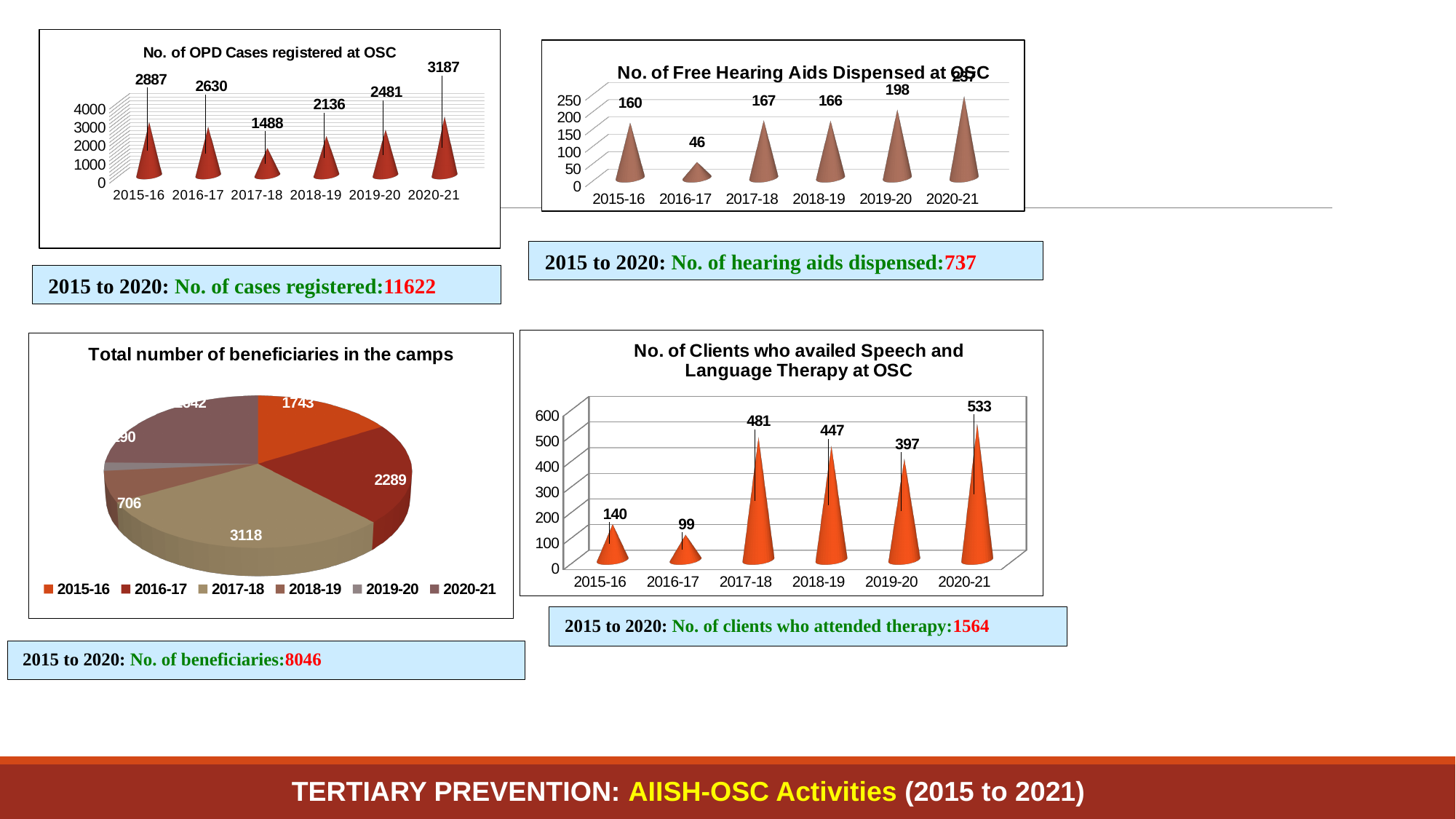
In the 'No. of Clients who availed Speech and Language Therapy at OSC' chart, do the values rise or fall from 2017-18 to 2019-20? Fall In the 'Total number of beneficiaries in the camps' chart, what is the value for 2017-18? 3118 In the 'No. of OPD Cases registered at OSC' chart, what is the difference between the values for 2015-16 and 2016-17? 257 In the 'No. of Free Hearing Aids Dispensed at OSC' chart, what is the value for 2016-17? 46 In the 'No. of Free Hearing Aids Dispensed at OSC' chart, is the value for 2015-16 greater or less than 100? greater In the 'No. of OPD Cases registered at OSC' chart, which year has the lowest value? 2017-18 What kind of chart is 'Total number of beneficiaries in the camps'? Pie chart In the 'No. of Clients who availed Speech and Language Therapy at OSC' chart, which year has the highest value? 2020-21 In the 'No. of Free Hearing Aids Dispensed at OSC' chart, which is larger, the value for 2017-18 or 2019-20? 2019-20 How many entries does the legend of the 'Total number of beneficiaries in the camps' chart list? 6 In the 'No. of Clients who availed Speech and Language Therapy at OSC' chart, what is the difference between the values for 2017-18 and 2018-19? 34 In the 'No. of OPD Cases registered at OSC' chart, what is the value for 2020-21? 3187